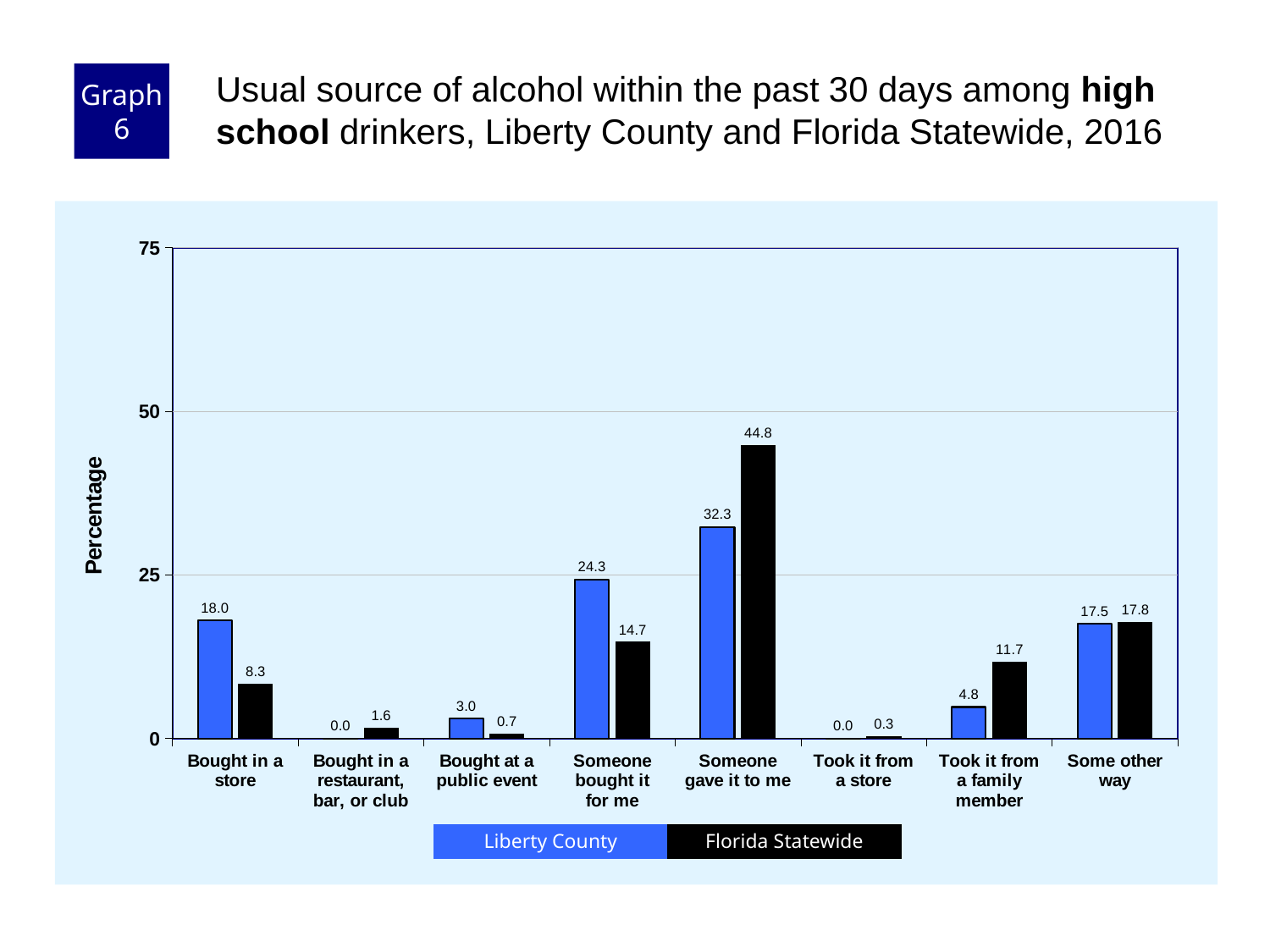
What is the Florida Statewide value for "Took it from a family member"? 11.7 Which category has the lowest Florida Statewide value? Took it from a store How many categories are shown on the x axis? 8 What is the difference between the Florida Statewide and Liberty County values for "Someone gave it to me"? 12.5 Which is larger for "Bought in a store": Liberty County or Florida Statewide? Liberty County What kind of chart is shown on the slide? Bar chart What is the difference between the Liberty County and Florida Statewide values for "Someone bought it for me"? 9.6 How many series does the legend list? 2 What is the Liberty County value for "Someone gave it to me"? 32.3 Is the Florida Statewide value for "Someone gave it to me" greater or less than 50? less What is the Liberty County value for "Bought in a store"? 18.0 Which category has the highest Florida Statewide value? Someone gave it to me